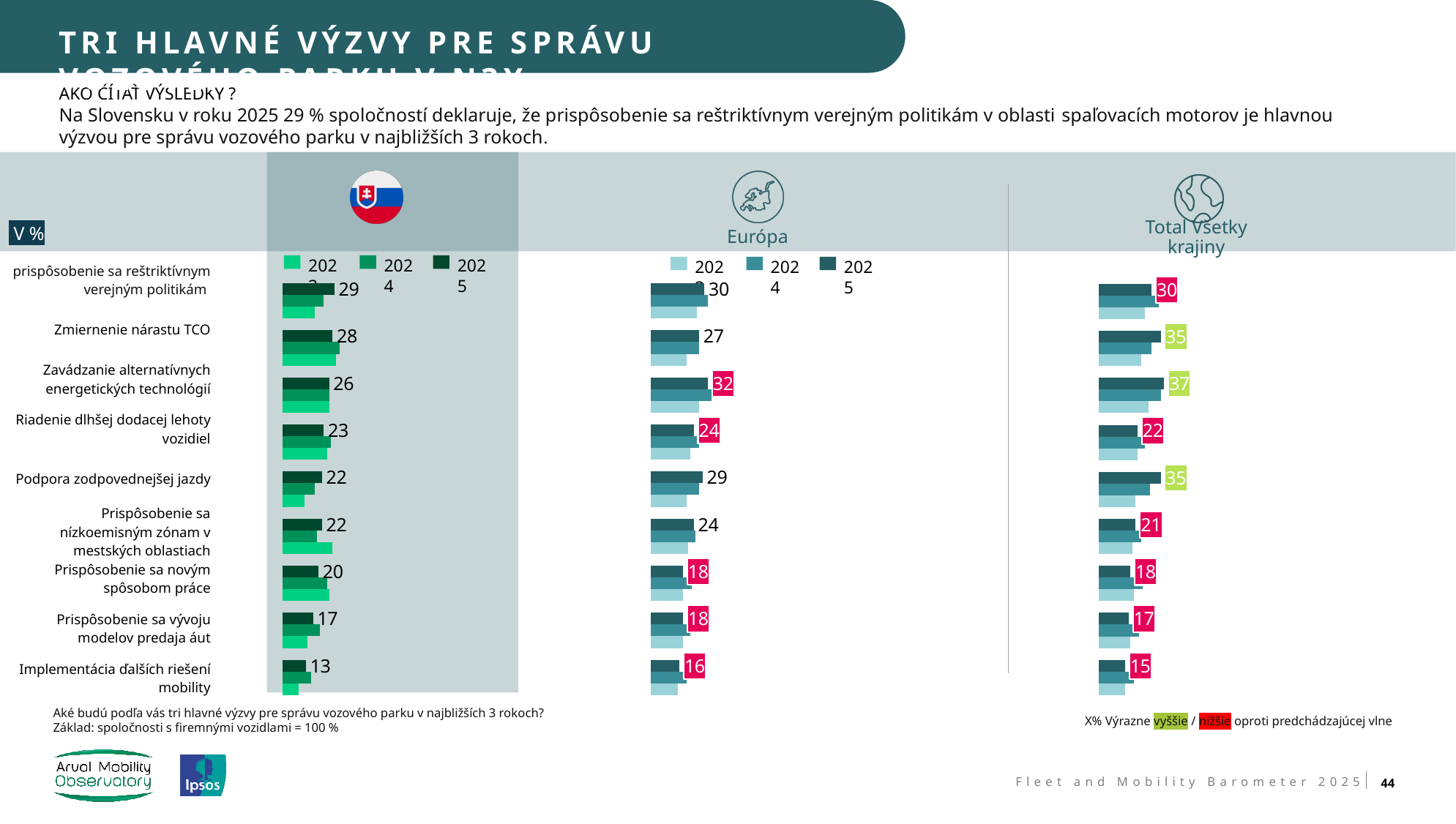
On the "Total všetky krajiny" chart, which has the larger 2025 value: "Zmiernenie nárastu TCO" or "Riadenie dlhšej dodacej lehoty vozidiel"? Zmiernenie nárastu TCO How many categories are plotted on the Slovakia chart (left, with the flag)? 9 On the Európa chart, what is the 2025 value for "Zavádzanie alternatívnych energetických technológií"? 32 On the "Total všetky krajiny" chart, which category has the highest 2025 value? Zavádzanie alternatívnych energetických technológií On the Slovakia chart (left, with the flag), what is the 2025 value for "Prispôsobenie sa vývoju modelov predaja áut"? 17 On the Slovakia chart (left, with the flag), what is the 2025 value for "Zmiernenie nárastu TCO"? 28 What kind of chart is the Slovakia chart (left, with the flag)? Bar chart On the "Total všetky krajiny" chart, what is the 2025 value for "Podpora zodpovednejšej jazdy"? 35 On the Slovakia chart (left, with the flag), which category has the lowest 2025 value? Implementácia ďalších riešení mobility On the "Total všetky krajiny" chart, what is the difference between the 2025 values for "Zavádzanie alternatívnych energetických technológií" and "Implementácia ďalších riešení mobility"? 22 How many series does the legend of the Európa chart list? 3 On the Európa chart, what is the difference between the 2025 values for "Zavádzanie alternatívnych energetických technológií" and "Implementácia ďalších riešení mobility"? 16